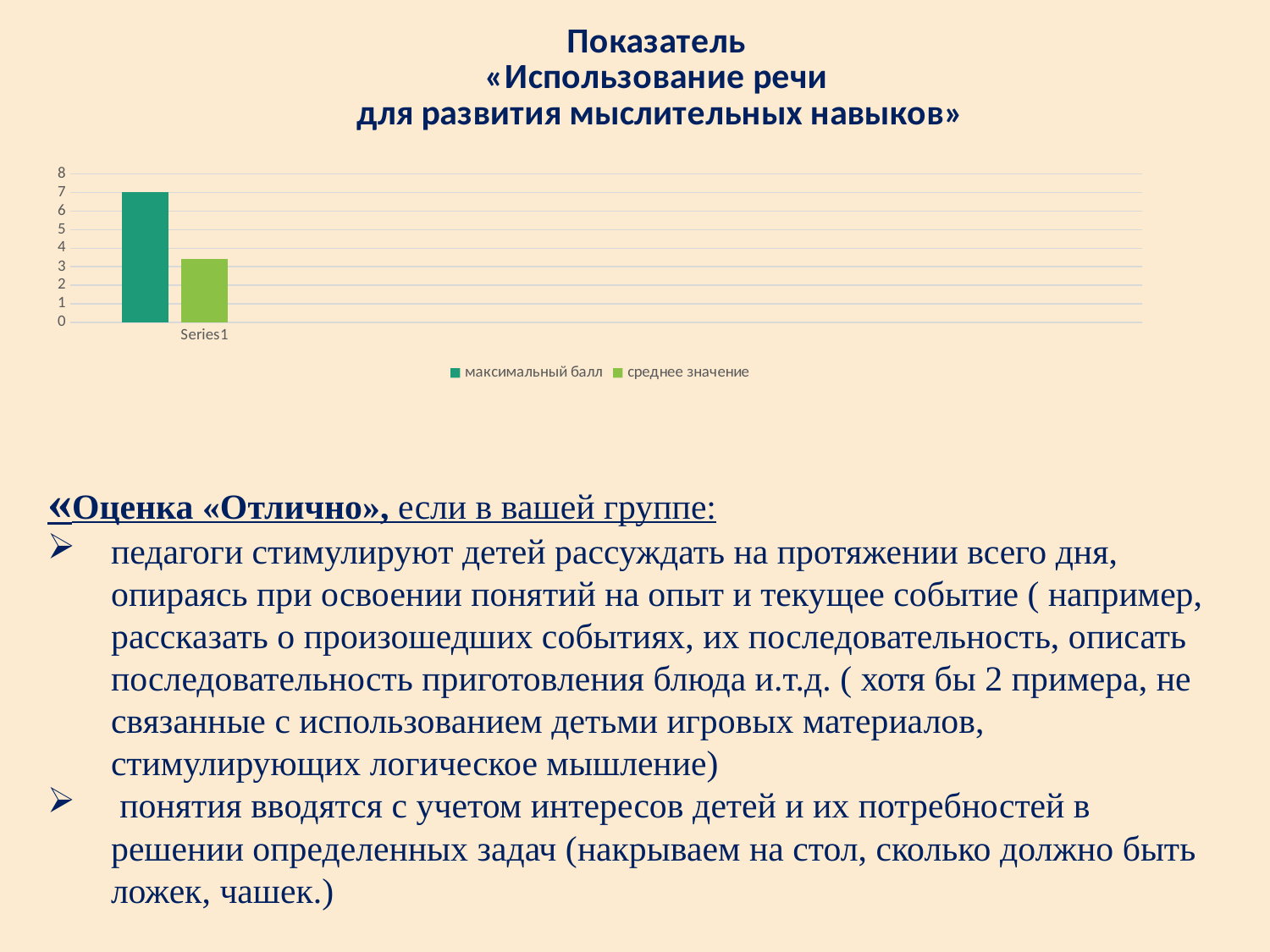
How many series does the chart legend list? 2 What is the value of the 'максимальный балл' bar? 7 How many categories are shown on the x axis of the chart? 1 Is the value for 'максимальный балл' greater or less than 8? less What is the category label shown on the x axis of the chart? Series1 Which series has the taller bar, 'максимальный балл' or 'среднее значение'? максимальный балл What are the two entries in the chart legend? максимальный балл, среднее значение Which series has the lowest value in the chart? среднее значение Is the value for 'среднее значение' greater or less than 2? greater What kind of chart is shown on the slide? bar chart Is the value for 'среднее значение' greater or less than 4? less Which series has the highest value in the chart? максимальный балл